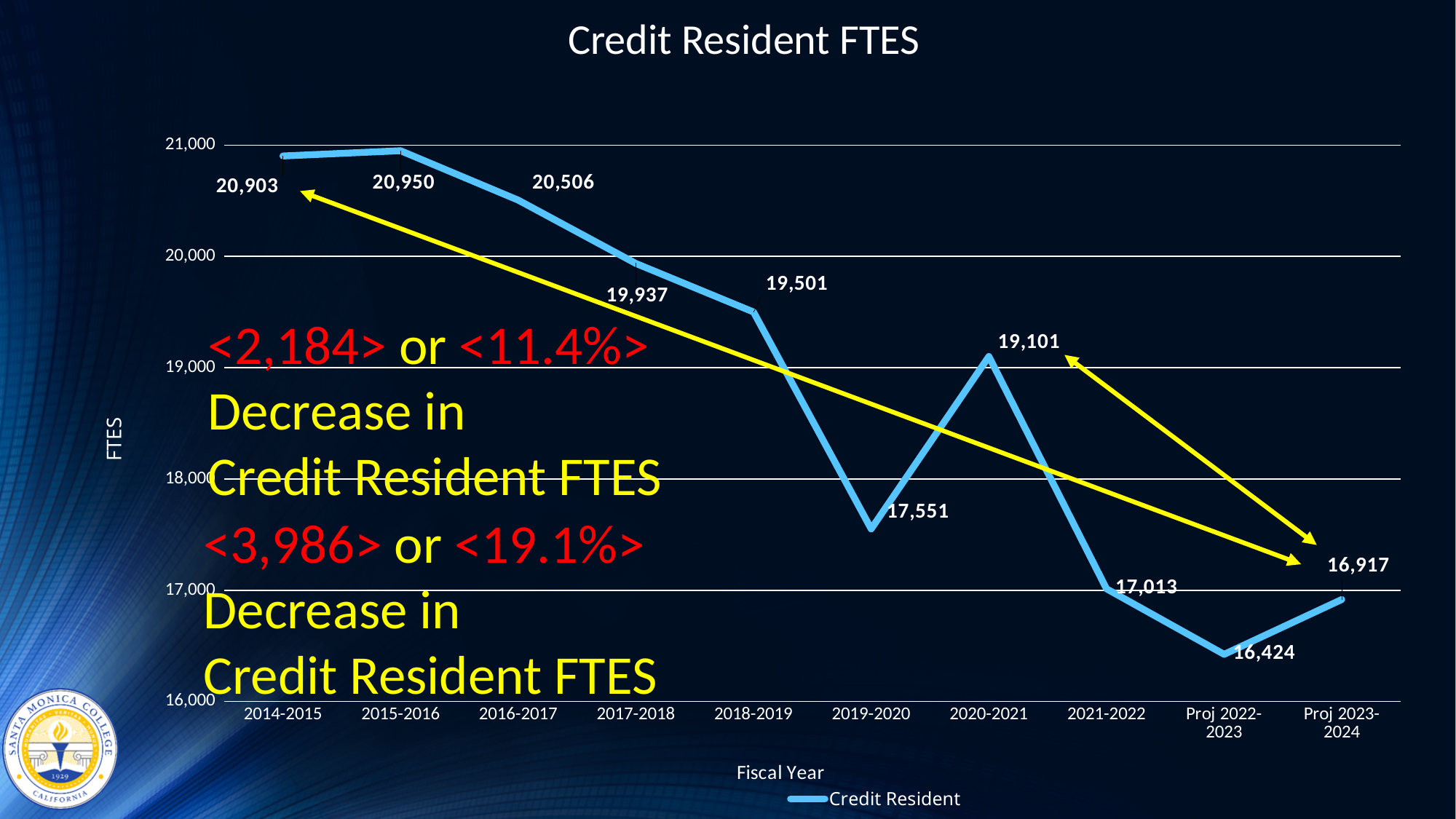
How many series does the legend list? 1 What is the label on the x axis of the chart? Fiscal Year Which is larger, the Credit Resident FTES for 2020-2021 or for 2021-2022? 2020-2021 What is the Credit Resident FTES value for 2019-2020? 17,551 What is the Credit Resident FTES value for Proj 2023-2024? 16,917 What is the difference in Credit Resident FTES between 2015-2016 and 2016-2017? 444 How many fiscal years are plotted on the chart? 10 What kind of chart is shown on the slide? line chart Which fiscal year has the highest Credit Resident FTES? 2015-2016 What is the Credit Resident FTES value for 2014-2015? 20,903 Which fiscal year has the lowest Credit Resident FTES? Proj 2022-2023 Is the Credit Resident FTES value for 2018-2019 greater or less than 20,000? less